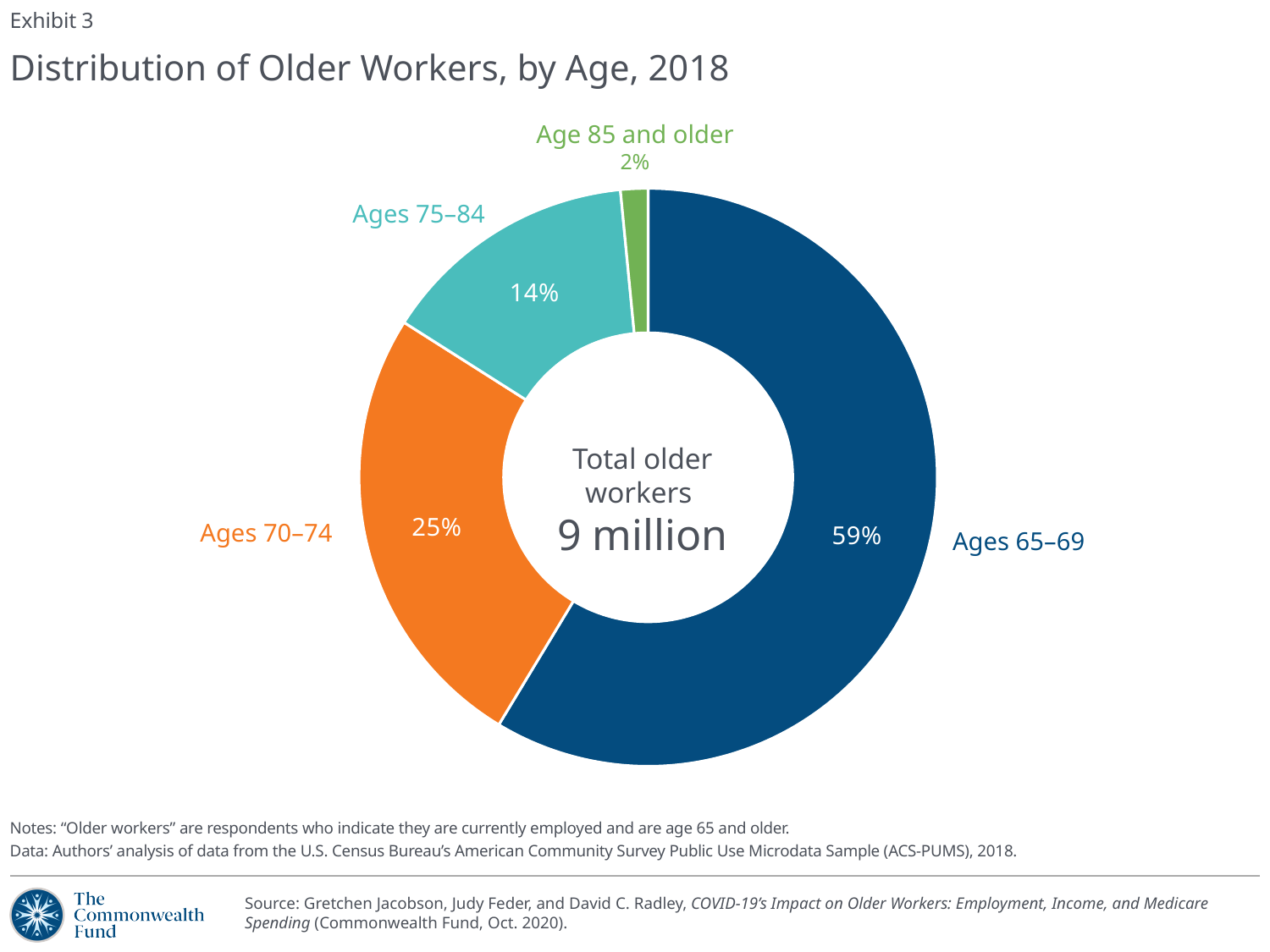
How many age groups are shown in the chart? 4 What share of older workers are age 85 and older? 2% Which age group makes up the largest share of older workers? Ages 65–69 What kind of chart is shown on the slide? Pie chart (donut) What share of older workers are ages 70–74? 25% What share of older workers are ages 65–69? 59% What is the total number of older workers shown in the center of the chart? 9 million Which is larger, the share for ages 75–84 or the share for age 85 and older? Ages 75–84 What share of older workers are ages 75–84? 14% Which age group makes up the smallest share of older workers? Age 85 and older How many percentage points larger is the share for ages 65–69 than for ages 70–74? 34 How many percentage points larger is the share for ages 70–74 than for ages 75–84? 11